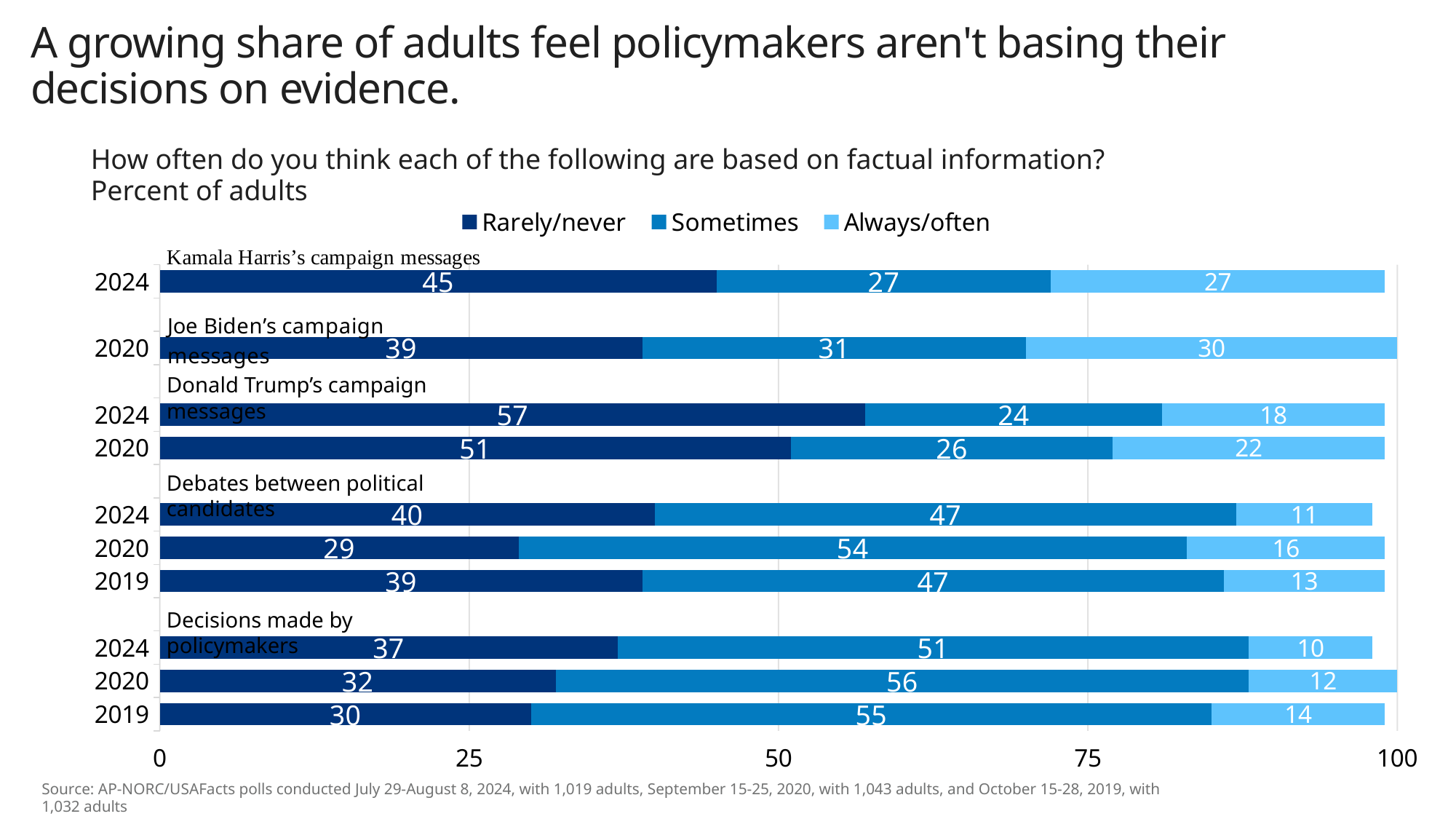
Which bar has the lowest Always/often value? Decisions made by policymakers, 2024 What is the difference between the Rarely/never values for Decisions made by policymakers in 2024 and 2019? 7 Which bar has the highest Rarely/never value? Donald Trump's campaign messages, 2024 Which is larger: the Sometimes value for Debates between political candidates in 2020 or in 2024? 2020 What is the total of the stacked bar for Joe Biden's campaign messages in 2020? 100 How many series does the legend list? 3 How many bars are plotted in the chart? 10 Which legend entry is shown in the lightest blue? Always/often What is the Always/often value for Kamala Harris's campaign messages in 2024? 27 What is the Rarely/never value for Donald Trump's campaign messages in 2024? 57 What is the Sometimes value for Decisions made by policymakers in 2020? 56 What kind of chart is shown on the slide? Stacked bar chart